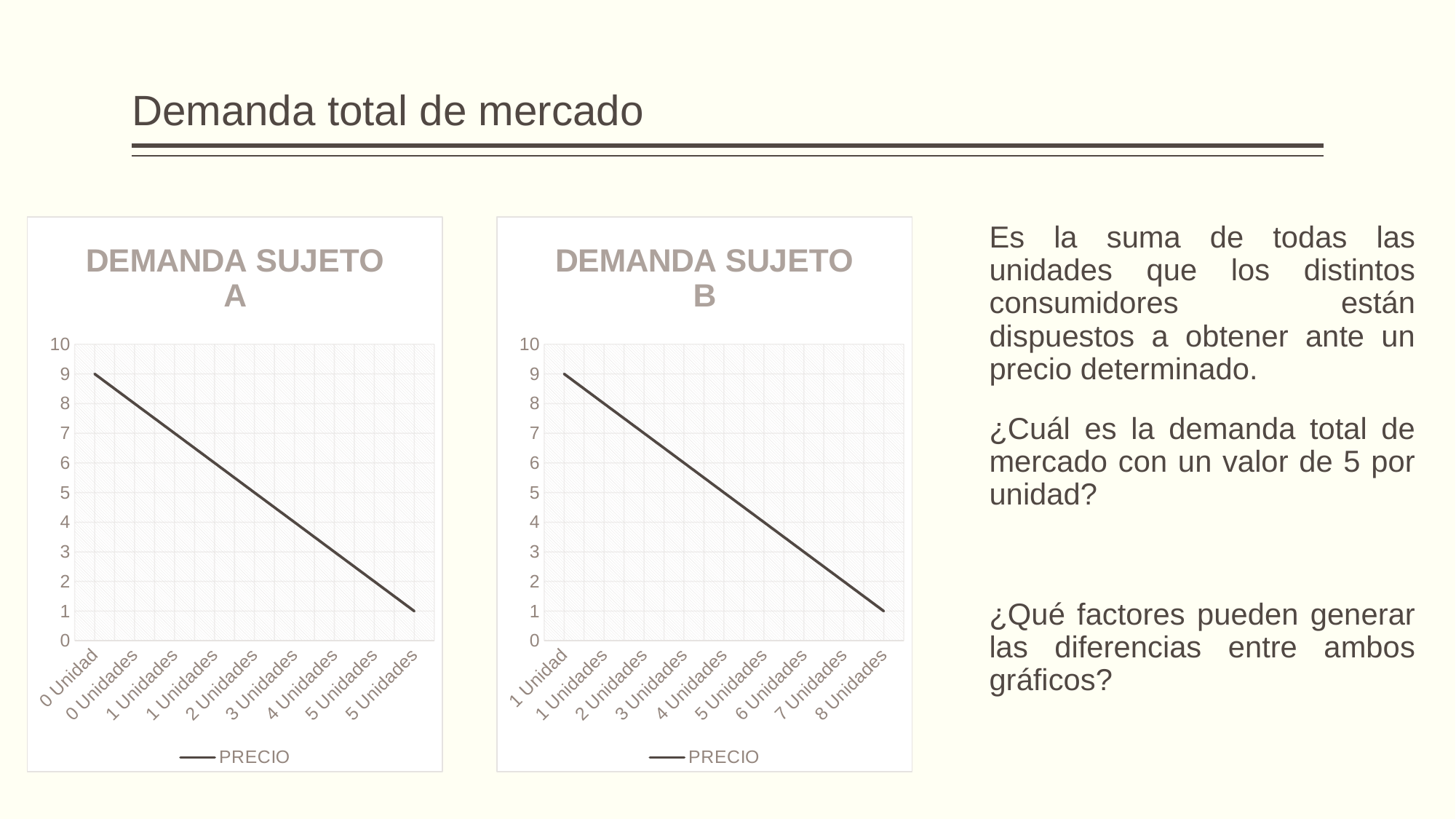
In the "DEMANDA SUJETO A" chart, do the values rise or fall along the x axis? fall In the "DEMANDA SUJETO B" chart, which category has the lowest PRECIO value? 8 Unidades In the "DEMANDA SUJETO A" chart, what is the PRECIO value for "0 Unidad"? 9 In the "DEMANDA SUJETO B" chart, what is the PRECIO value for "8 Unidades"? 1 What kind of chart is "DEMANDA SUJETO A"? line chart What is the name of the series shown in the legend of the "DEMANDA SUJETO A" chart? PRECIO How many series does the legend of the "DEMANDA SUJETO B" chart list? 1 In the "DEMANDA SUJETO B" chart, is the PRECIO value for "6 Unidades" greater or less than 5? less In the "DEMANDA SUJETO B" chart, what is the PRECIO value for "1 Unidad"? 9 In the "DEMANDA SUJETO B" chart, how many categories are shown on the x axis? 9 What kind of chart is "DEMANDA SUJETO B"? line chart In the "DEMANDA SUJETO A" chart, how many categories are shown on the x axis? 9